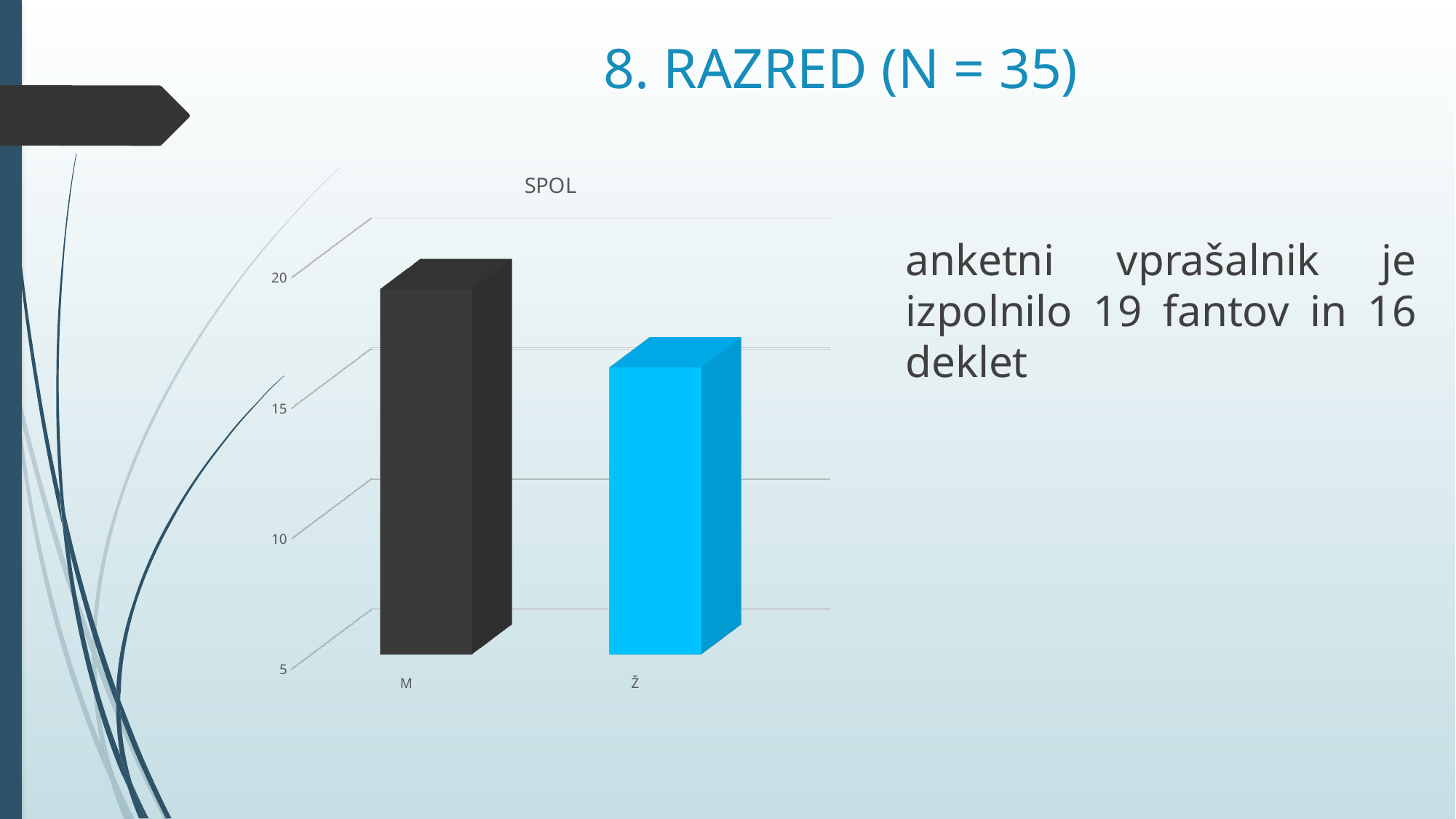
Do the bar values rise or fall from M to Ž along the x axis? fall Which bar is taller, M or Ž? M Is the value for M greater or less than 15? greater What colour is the bar for Ž? light blue How many categories are shown on the x axis of the chart? 2 Is the value for Ž greater or less than 10? greater What is the title of the chart? SPOL Which category has the lowest bar in the chart? Ž What type of chart is shown on the slide? bar chart Which category has the highest bar in the chart? M Is the value for Ž greater or less than 20? less